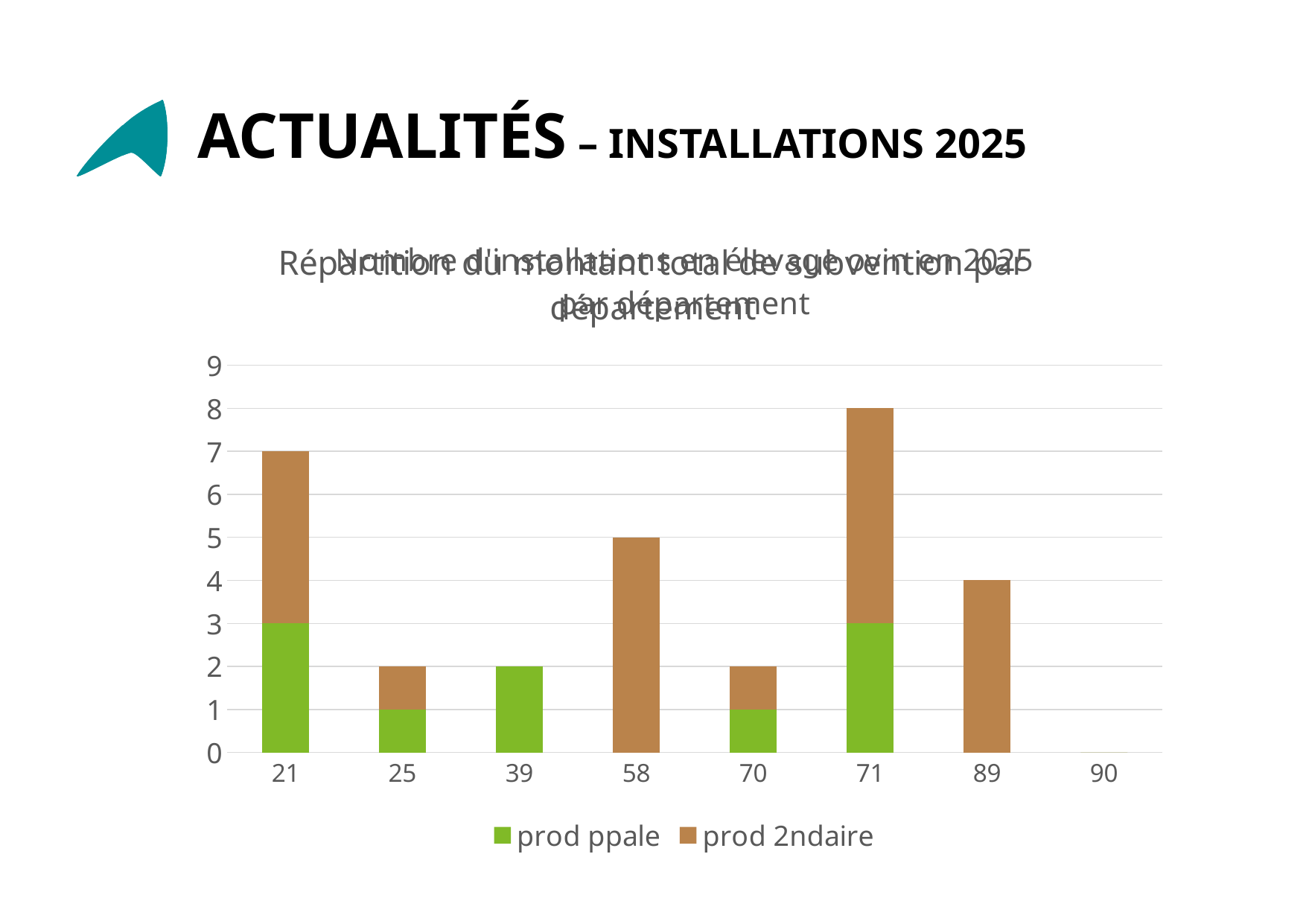
What type of chart is shown on the slide? stacked bar chart What is the value of 'prod ppale' for department 21? 3 How many departments (categories) are shown on the x axis? 8 What is the difference between the total bar for department 71 and the total bar for department 25? 6 Which is larger, the total bar for department 58 or for department 89? 58 What is the total height of the stacked bar for department 71? 8 What is the value of 'prod 2ndaire' for department 89? 4 Which colour represents 'prod ppale' in the legend? green How many series does the legend list? 2 What is the total height of the stacked bar for department 21? 7 Which department has the highest stacked bar? 71 What is the value of 'prod 2ndaire' for department 58? 5